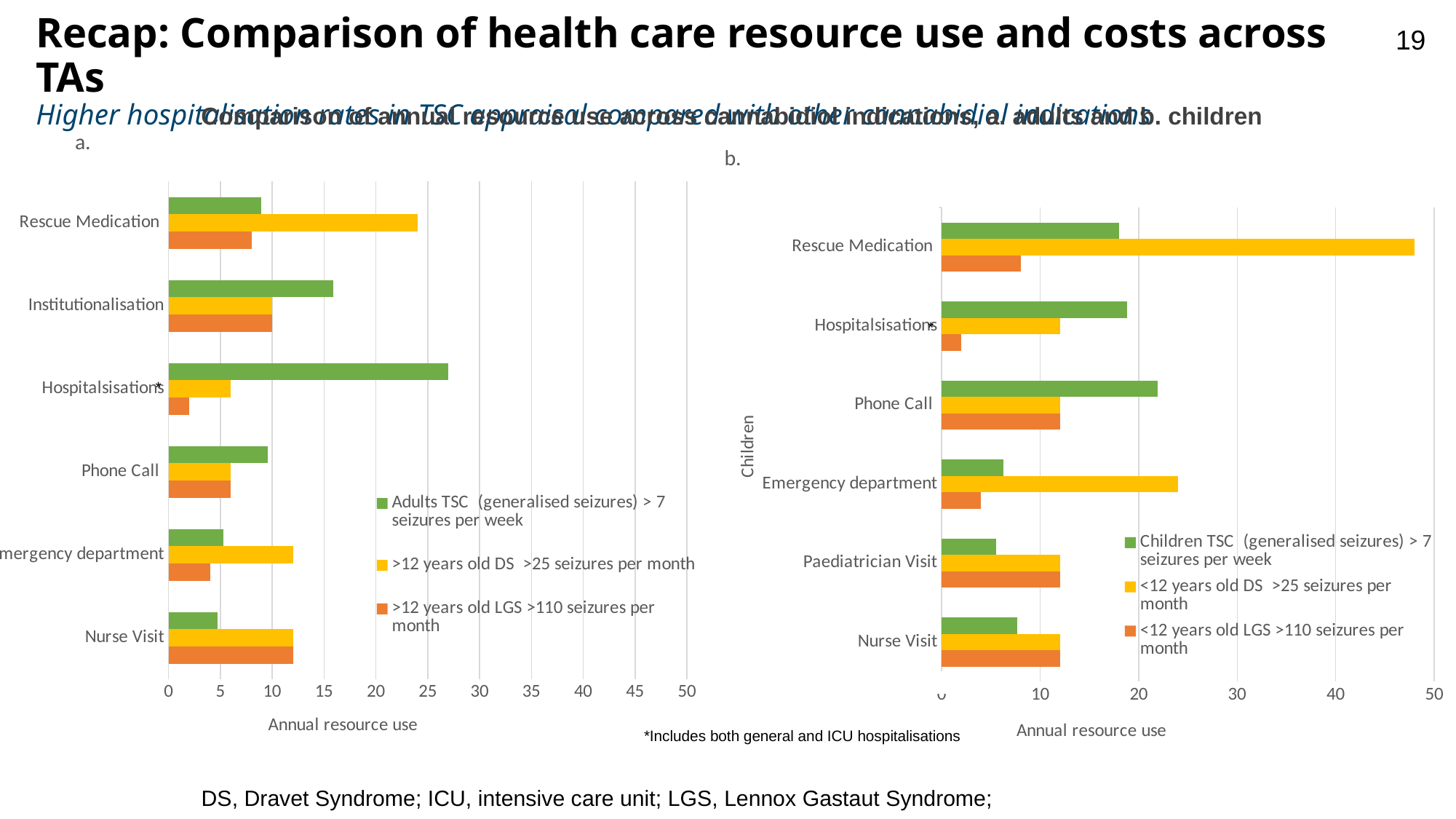
In chart b. (the right chart), which category has the lowest value for <12 years old LGS >110 seizures per month? Hospitalsisations In chart a. (the left chart), for Rescue Medication, which series has the larger value: >12 years old DS or >12 years old LGS? >12 years old DS How many series does the legend of chart b. (the right chart) list? 3 In chart b. (the right chart), for Phone Call, which series has the larger value: Children TSC or <12 years old LGS? Children TSC What is the x-axis title of chart a. (the left chart)? Annual resource use In chart a. (the left chart), which category has the highest value for Adults TSC (generalised seizures) > 7 seizures per week? Hospitalsisations In chart b. (the right chart), is the <12 years old DS value for Emergency department greater or less than 20? greater What kind of chart is chart a. (the left chart)? bar chart In chart b. (the right chart), which category has the highest value for <12 years old DS >25 seizures per month? Rescue Medication In chart a. (the left chart), is the Adults TSC value for Hospitalsisations greater or less than 25? greater How many categories are shown on the y axis of chart a. (the left chart)? 6 In chart b. (the right chart), is the <12 years old DS value for Rescue Medication greater or less than 40? greater